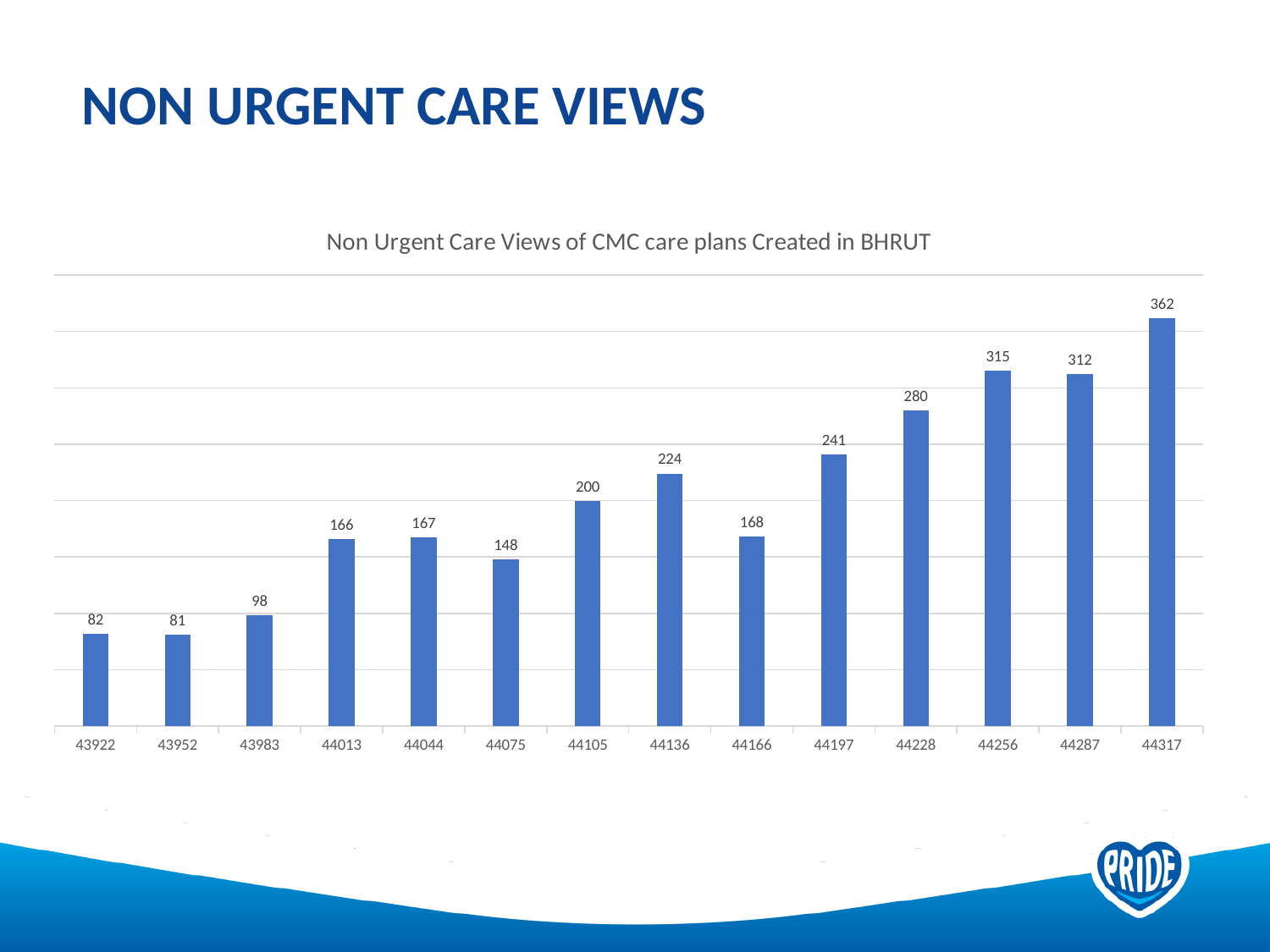
Which is larger, the value for 44013 or the value for 44075? 44013 What is the title of the chart? Non Urgent Care Views of CMC care plans Created in BHRUT Do the values generally rise or fall from left to right along the x axis? Rise What is the difference between the values for 44317 and 44287? 50 What is the difference between the values for 44136 and 44166? 56 What is the value for category 44105? 200 What kind of chart is this? Bar chart What is the value for category 43983? 98 Which category has the lowest value? 43952 Which category has the highest value? 44317 What is the value for category 44228? 280 How many categories are shown on the x axis? 14